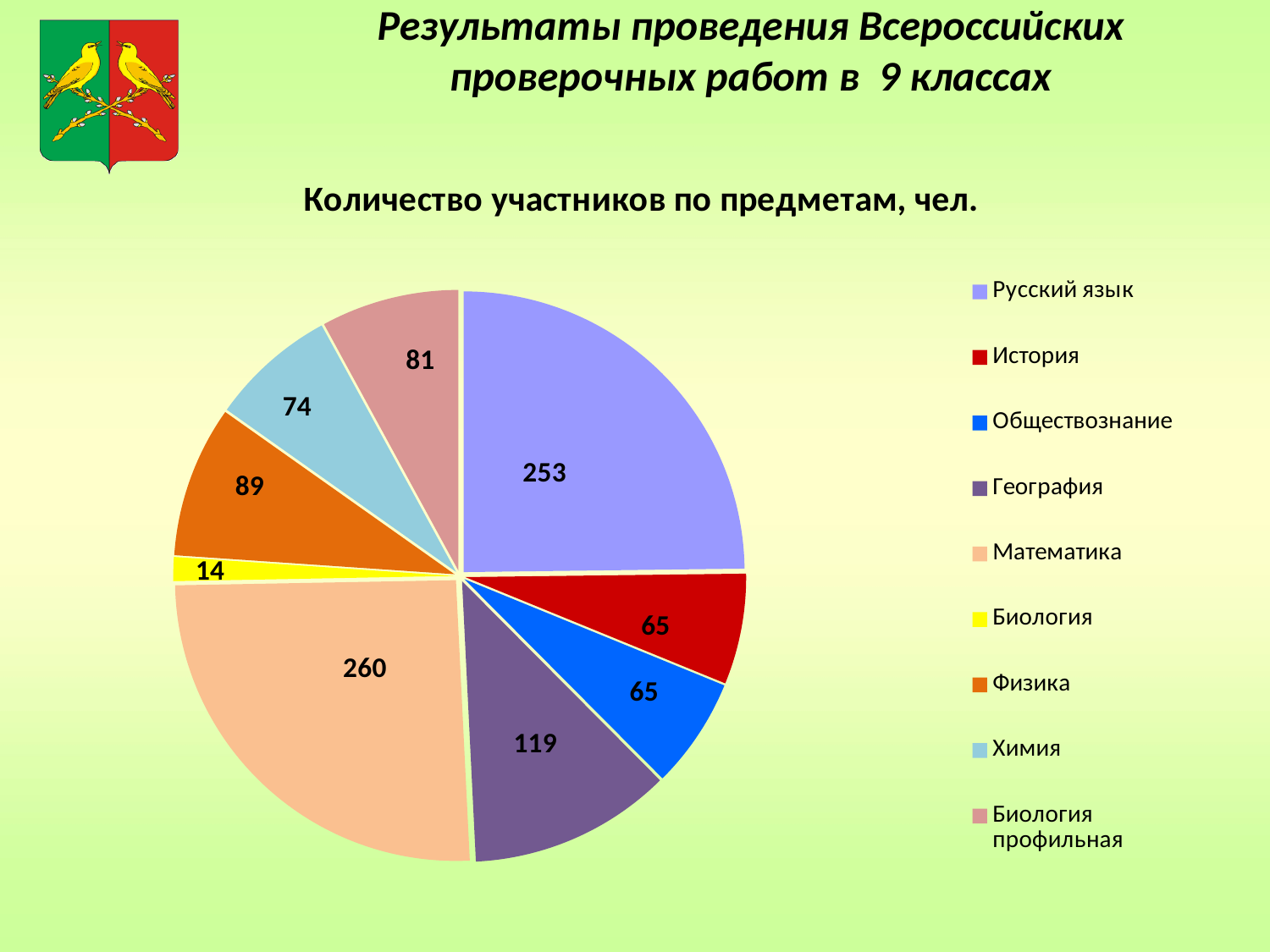
What is the value for География? 119 Which subject has the smallest number of participants? Биология What is the value for Химия? 74 How many subjects (slices) does the pie chart show? 9 What is the difference between the values for Математика and Русский язык? 7 What kind of chart is shown on the slide? pie chart What is the value for Русский язык? 253 How many participants are shown for Математика? 260 Which is larger, the value for География or the value for Биология профильная? География What is the difference between the values for Физика and Химия? 15 Which subject has the largest number of participants? Математика What is the title of the chart? Количество участников по предметам, чел.